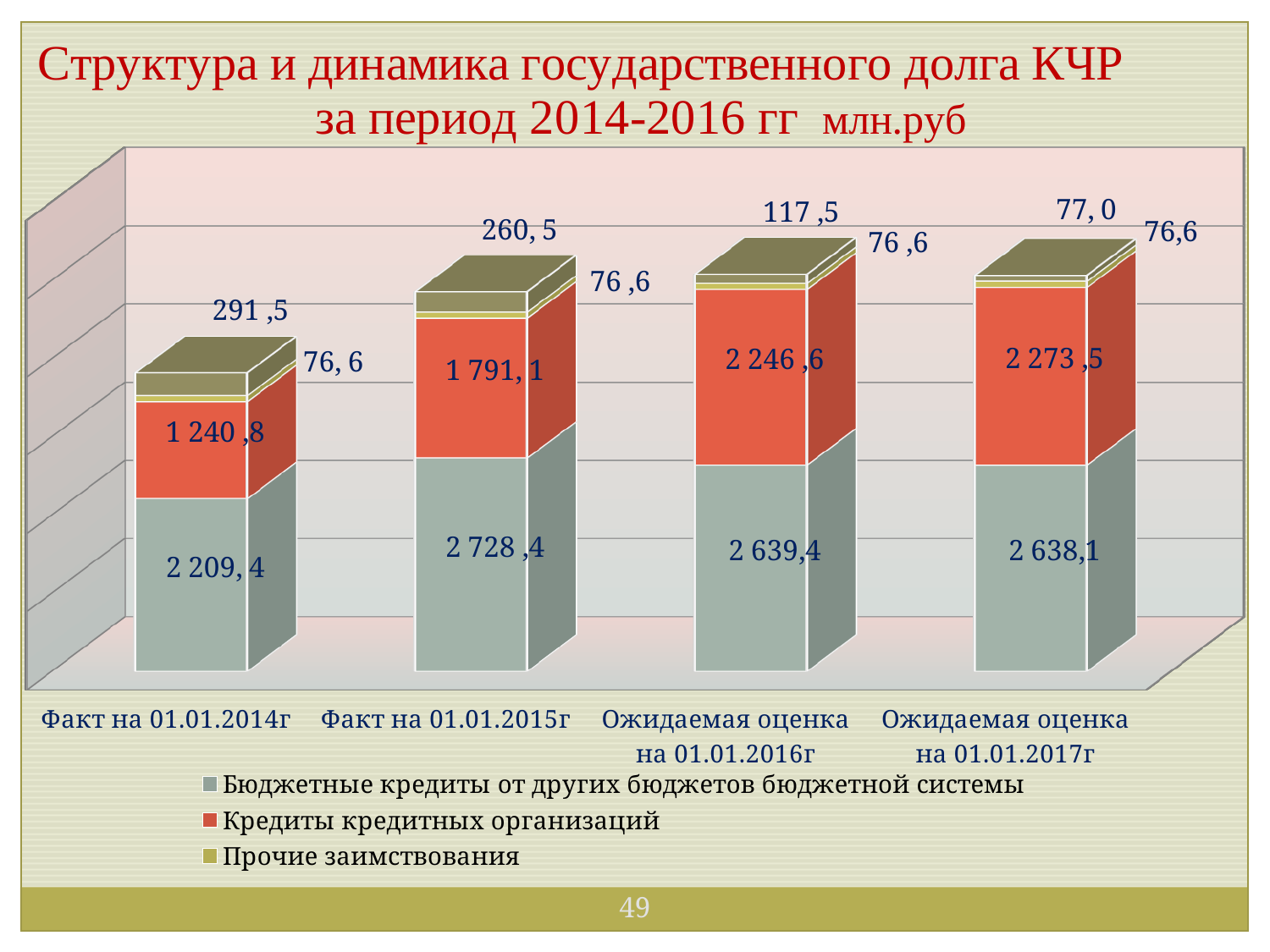
How many categories are shown on the x axis? 4 What is the value of 'Бюджетные кредиты от других бюджетов бюджетной системы' for 'Ожидаемая оценка на 01.01.2017г'? 2 638,1 What is the value of 'Кредиты кредитных организаций' for 'Факт на 01.01.2015г'? 1 791,1 What is the difference in 'Кредиты кредитных организаций' between 'Ожидаемая оценка на 01.01.2017г' and 'Ожидаемая оценка на 01.01.2016г'? 26,9 Does 'Кредиты кредитных организаций' rise or fall from 'Факт на 01.01.2014г' to 'Ожидаемая оценка на 01.01.2017г'? Rise What is the value of 'Бюджетные кредиты от других бюджетов бюджетной системы' for 'Факт на 01.01.2014г'? 2 209,4 For which category is 'Кредиты кредитных организаций' the lowest? Факт на 01.01.2014г What is the value of 'Кредиты кредитных организаций' for 'Ожидаемая оценка на 01.01.2016г'? 2 246,6 How many series does the legend list? 3 Which is larger: 'Бюджетные кредиты от других бюджетов бюджетной системы' for 'Факт на 01.01.2015г' or for 'Факт на 01.01.2014г'? Факт на 01.01.2015г For which category is 'Бюджетные кредиты от других бюджетов бюджетной системы' the highest? Факт на 01.01.2015г What kind of chart is shown on the slide? Stacked bar chart